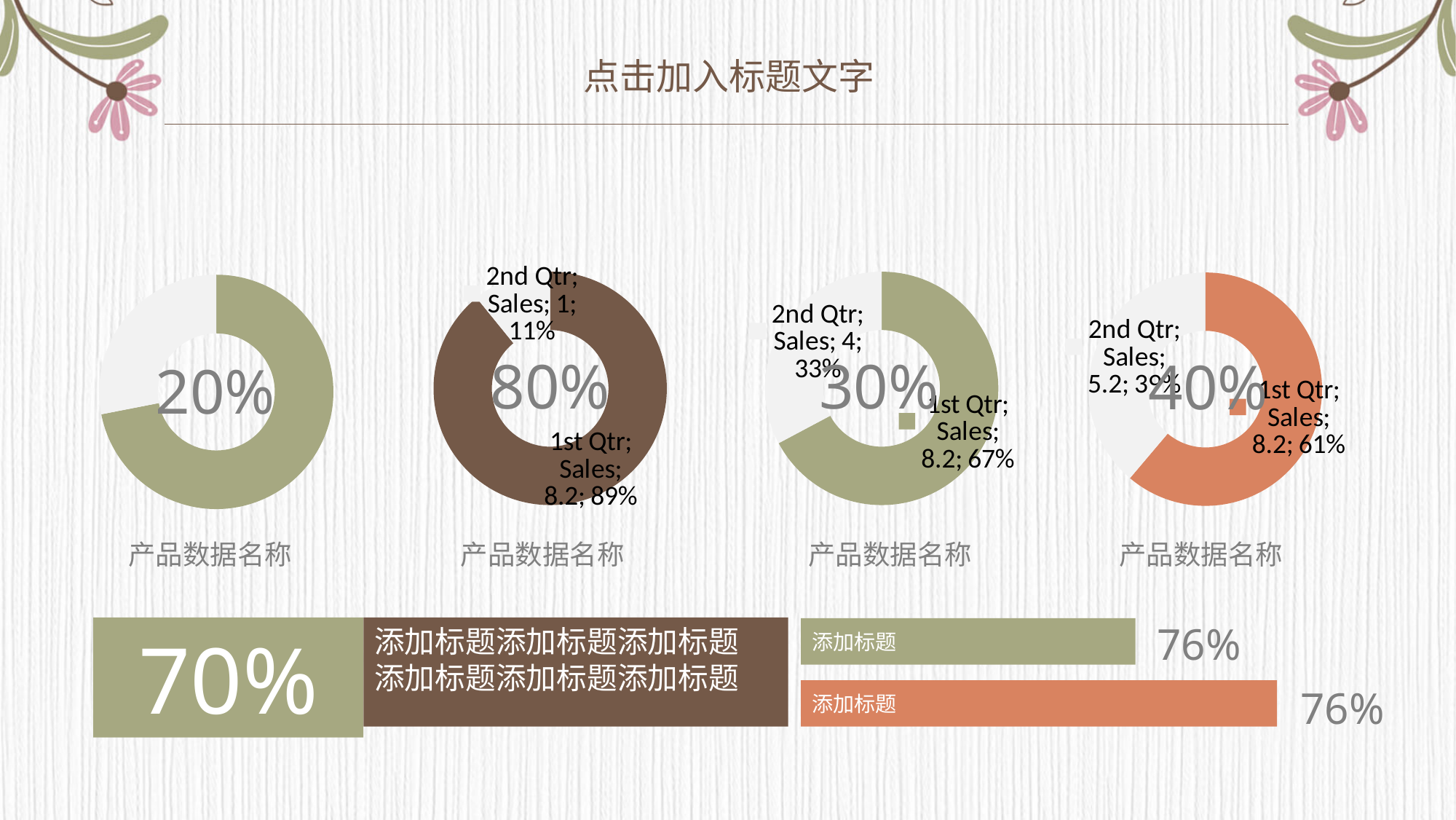
In the third doughnut chart from the left, what is the difference between the 1st Qtr and 2nd Qtr values? 4.2 In the rightmost doughnut chart, what is the value for 2nd Qtr? 5.2 What kind of chart is the rightmost chart in the row of four? Doughnut chart In the rightmost doughnut chart, which category has the largest slice? 1st Qtr In the rightmost doughnut chart, what share of the whole does 1st Qtr represent? 61% In the second doughnut chart from the left, what is the total of the two slices? 9.2 In the third doughnut chart from the left, what is the value for 2nd Qtr? 4 In the third doughnut chart from the left, what share of the whole does 1st Qtr represent? 67% In the second doughnut chart from the left, which is larger, 1st Qtr or 2nd Qtr? 1st Qtr In the second doughnut chart from the left, what share of the whole does 2nd Qtr represent? 11% How many categories are shown in the third doughnut chart from the left? 2 In the second doughnut chart from the left, what is the value for 1st Qtr? 8.2